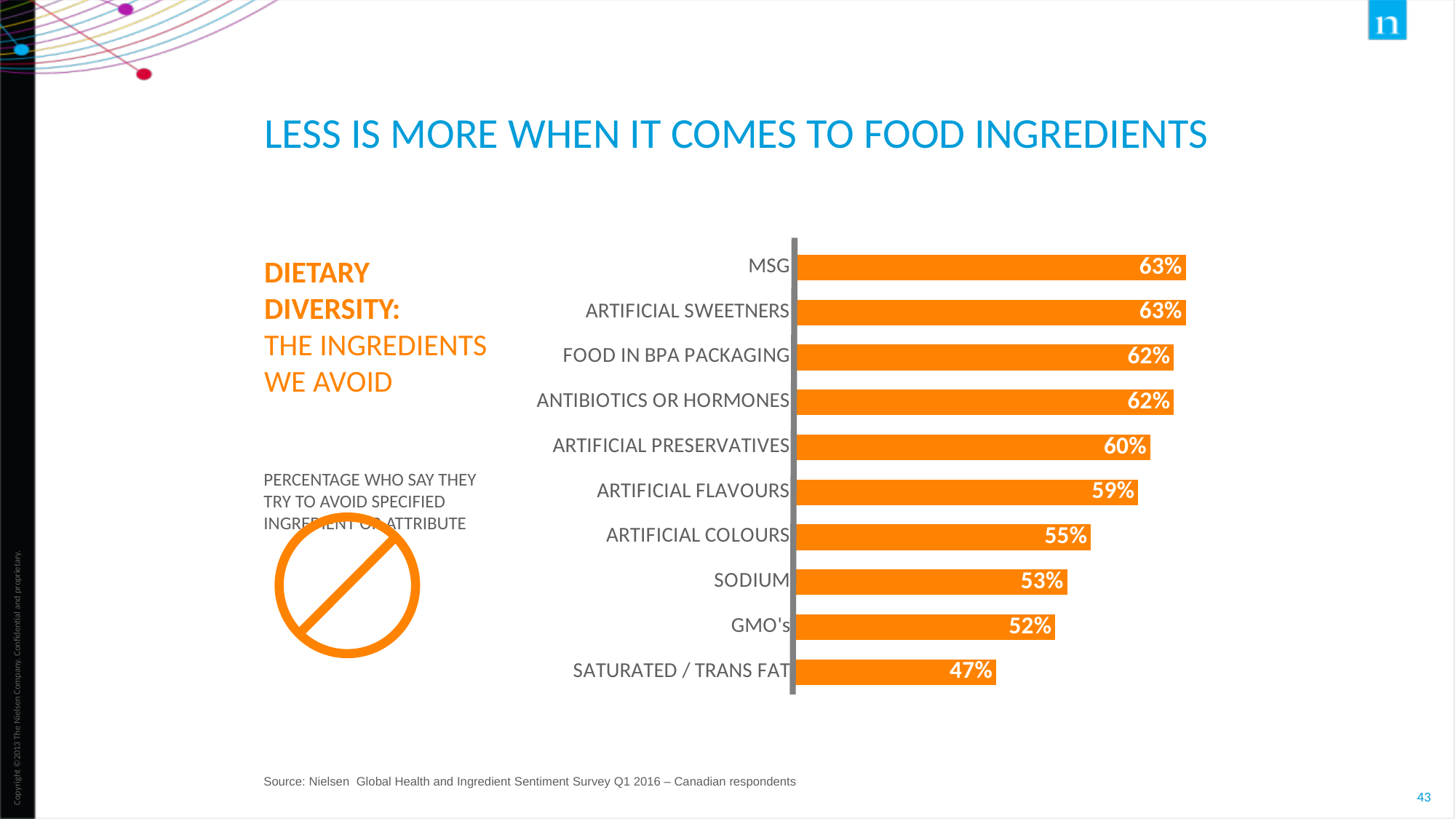
How many ingredients or attributes are listed in the chart? 10 What percentage of respondents say they try to avoid MSG? 63% What is the value shown for Artificial Colours? 55% Which has a higher value, Sodium or GMO's? Sodium What is the difference between the values for MSG and Saturated / Trans Fat? 16% What kind of chart is shown on the slide? Bar chart What percentage is shown for Saturated / Trans Fat? 47% What colour are the bars in the chart? Orange Which has a higher value, Artificial Flavours or Artificial Colours? Artificial Flavours What is the difference between the values for Artificial Preservatives and Sodium? 7% Which ingredient has the lowest percentage of people trying to avoid it? Saturated / Trans Fat What is the value for GMO's? 52%